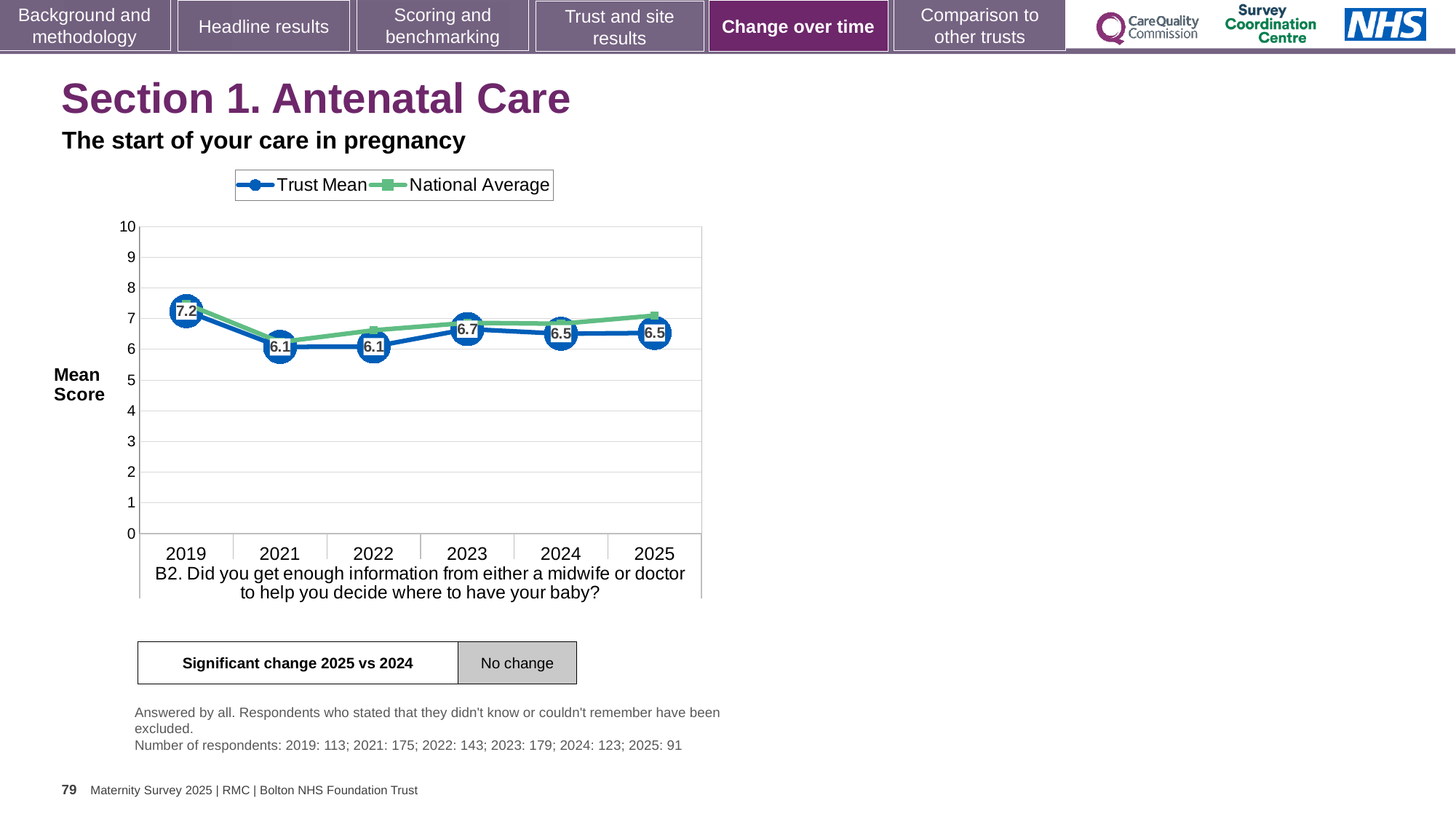
Is the National Average for 2021 greater or less than 7? less Which year has the larger Trust Mean, 2023 or 2024? 2023 Is the National Average for 2019 greater or less than 7? greater What kind of chart is shown? Line chart How many series does the legend list? 2 In which year is the Trust Mean highest? 2019 What is the difference between the Trust Mean in 2019 and in 2021? 1.1 How many years are plotted on the x axis? 6 What is the Trust Mean for 2023? 6.7 What is the Trust Mean for 2019? 7.2 Does the Trust Mean rise or fall from 2019 to 2021? Fall What is the Trust Mean for 2025? 6.5